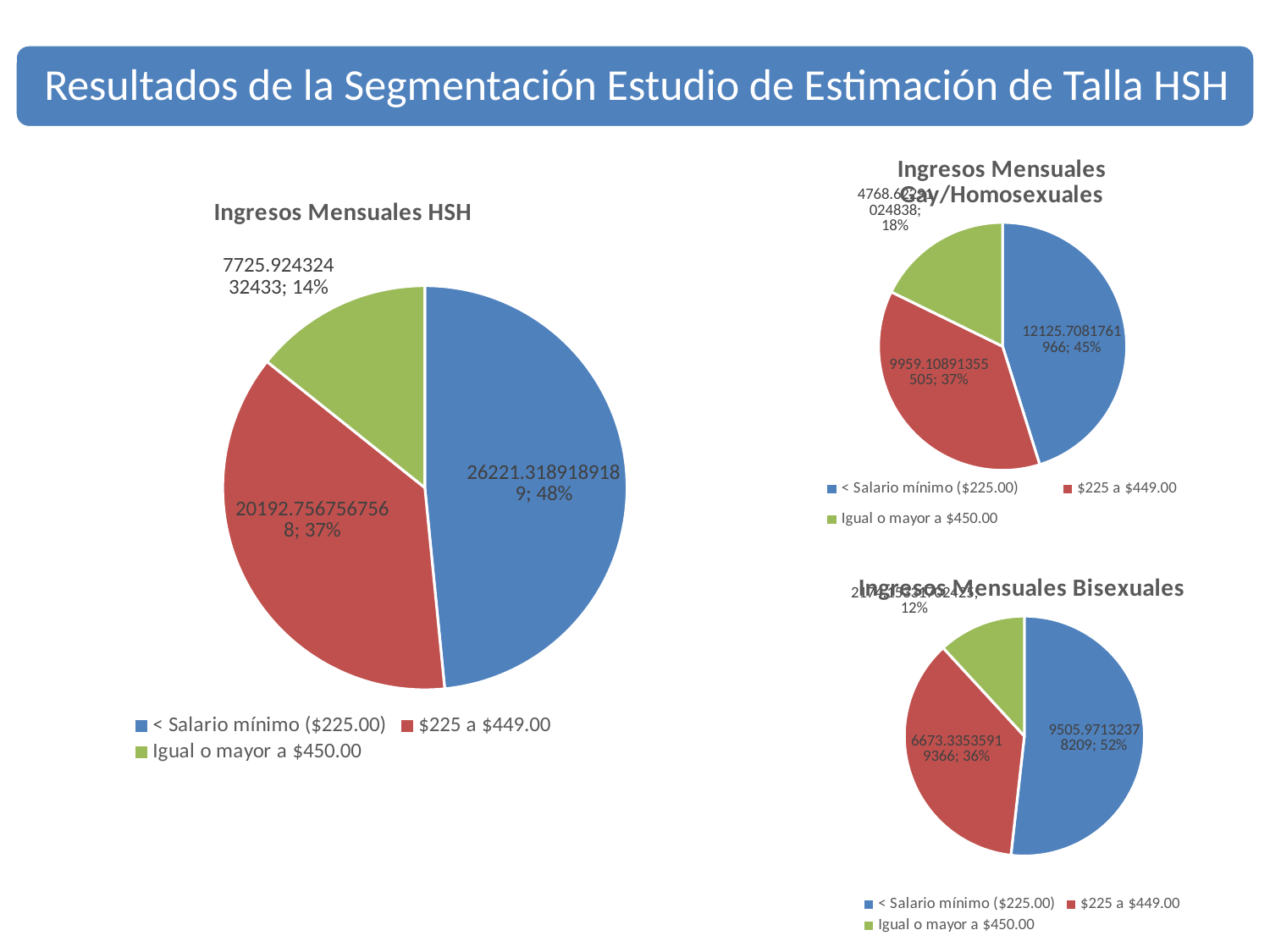
In the 'Ingresos Mensuales HSH' chart, what percentage share does the 'Igual o mayor a $450.00' slice have? 14% How many slices does the 'Ingresos Mensuales HSH' pie chart have? 3 In the 'Ingresos Mensuales Bisexuales' chart, what percentage share does the '< Salario mínimo ($225.00)' slice have? 52% In the 'Ingresos Mensuales HSH' chart, which category has the smallest slice? Igual o mayor a $450.00 In the 'Ingresos Mensuales HSH' chart, what percentage share does the '< Salario mínimo ($225.00)' slice have? 48% What kind of chart is 'Ingresos Mensuales HSH'? Pie chart In the 'Ingresos Mensuales HSH' chart, which category has the largest slice? < Salario mínimo ($225.00) Which chart shows a larger percentage share for '< Salario mínimo ($225.00)': 'Ingresos Mensuales Gay/Homosexuales' or 'Ingresos Mensuales Bisexuales'? Ingresos Mensuales Bisexuales In the 'Ingresos Mensuales Bisexuales' chart, which category has the smallest slice? Igual o mayor a $450.00